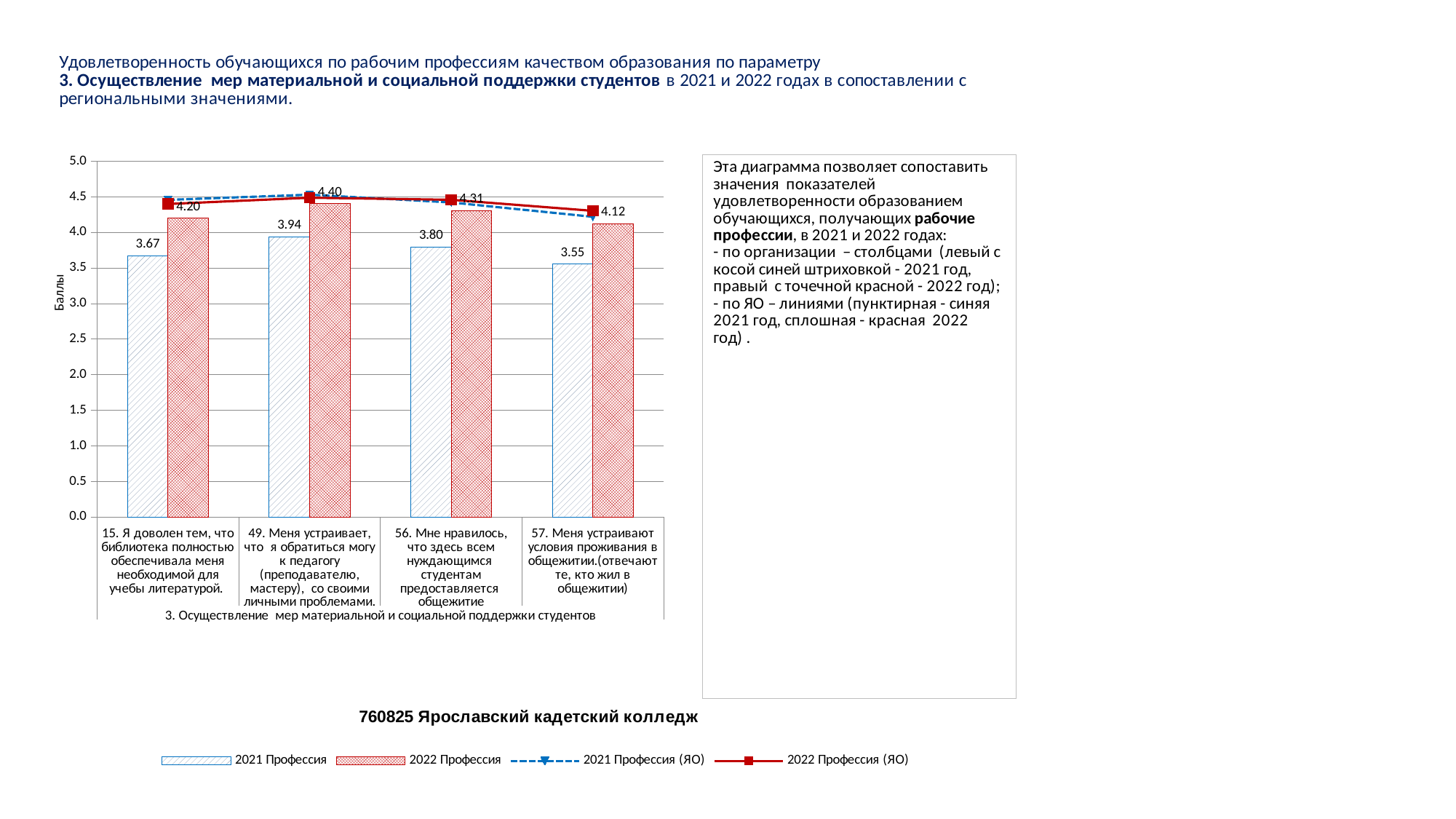
What is the difference between the 2022 and 2021 Профессия values for question 57? 0.57 Which is larger for question 15: the 2021 Профессия value or the 2022 Профессия value? 2022 Профессия Which question has the lowest 2021 Профессия value? 57. Меня устраивают условия проживания в общежитии.(отвечают те, кто жил в общежитии) How many question categories are shown on the x axis? 4 What is the 2021 Профессия value for question 57 (satisfied with dormitory living conditions)? 3.55 How many series does the legend list? 4 Is the 2021 Профессия (ЯО) line value for question 15 greater or less than 4.0? greater What is the 2022 Профессия value for question 56 (dormitory provided to all students in need)? 4.31 What is the label of the vertical axis? Баллы Which question has the highest 2022 Профессия value? 49. Меня устраивает, что я обратиться могу к педагогу (преподавателю, мастеру), со своими личными проблемами. What is the 2022 Профессия value for question 49 (can approach a teacher/master with personal problems)? 4.40 What is the 2021 Профессия value for question 15 (library provided necessary literature)? 3.67